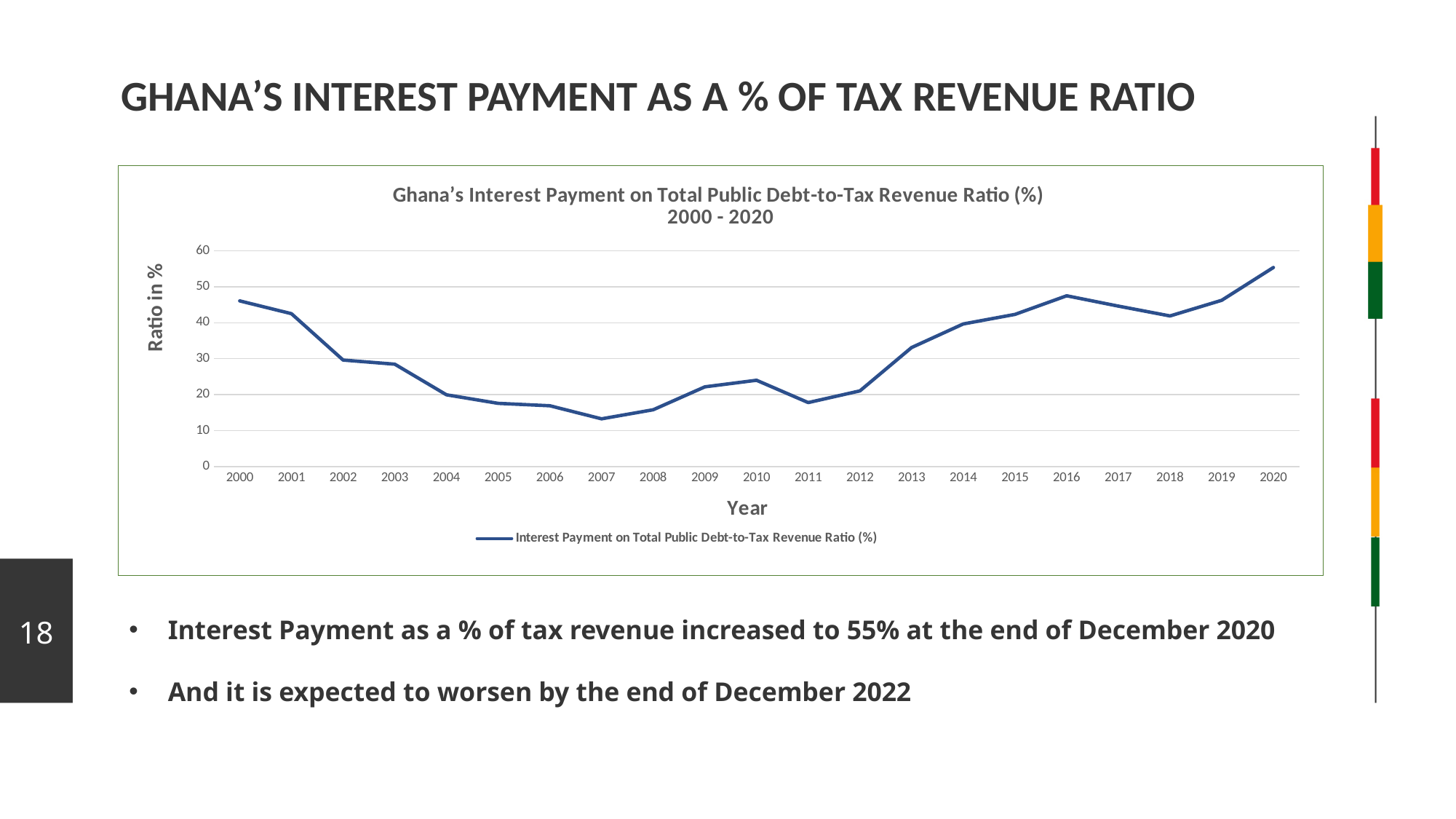
Which year has the lowest Interest Payment on Total Public Debt-to-Tax Revenue Ratio? 2007 How many years are plotted along the x axis? 21 What is the label on the y axis? Ratio in % Is the value for 2011 greater or less than 20? less Is the value for 2007 greater or less than 20? less Is the value for 2020 greater or less than 50? greater Which year has the highest Interest Payment on Total Public Debt-to-Tax Revenue Ratio? 2020 Do the values rise or fall from 2000 to 2007? fall Which year has the larger ratio, 2002 or 2012? 2002 How many series does the legend list? 1 What kind of chart is shown on the slide? Line chart